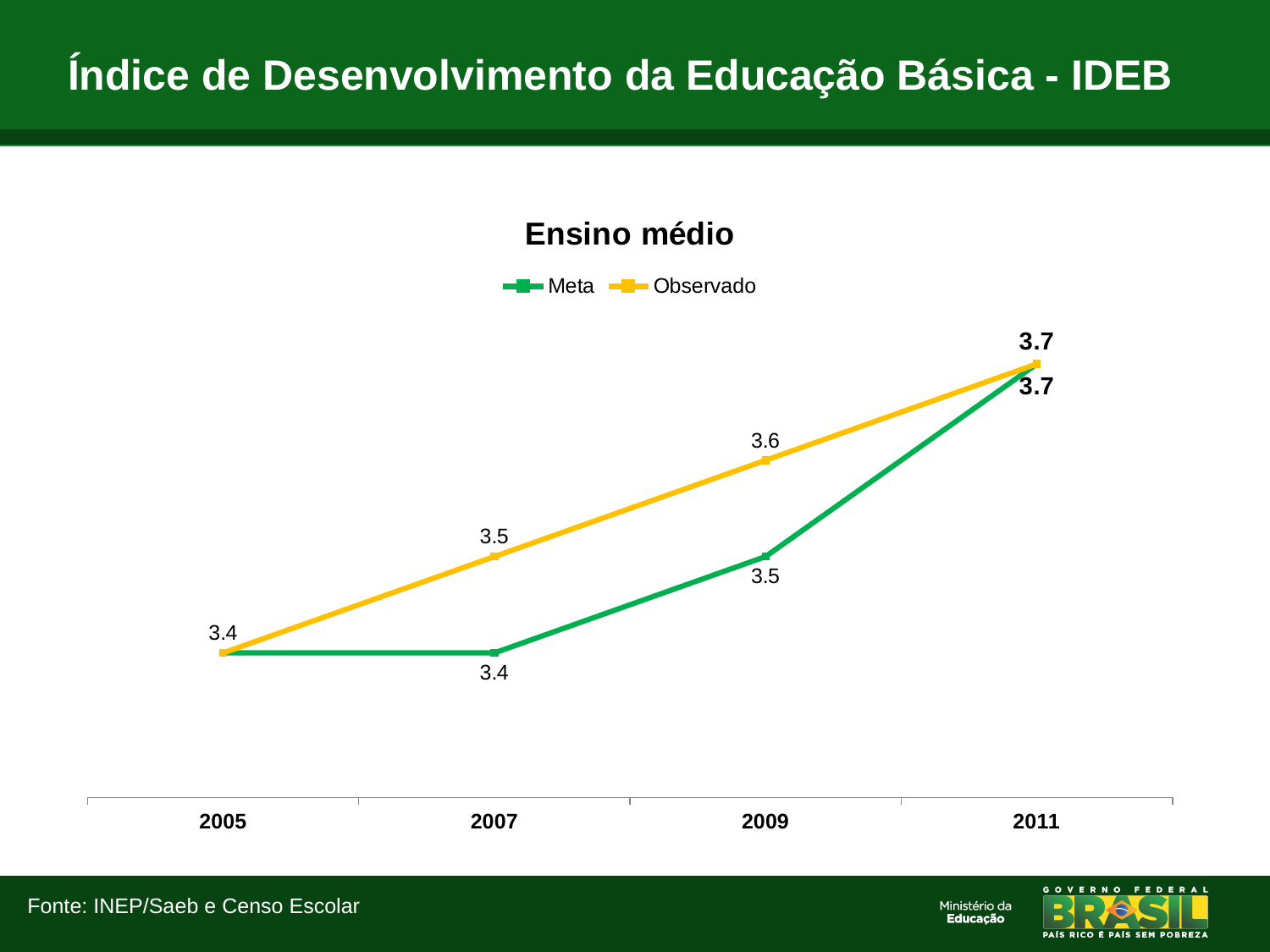
How many years are shown on the x axis? 4 What is the Observado value for 2007? 3.5 What is the Meta value for 2011? 3.7 How many series does the legend list? 2 What type of chart is shown on the slide? line chart In which year is the Observado series highest? 2011 What is the Observado value for 2009? 3.6 What is the difference between the Observado and Meta values in 2009? 0.1 Does the Observado series rise or fall from 2005 to 2011? rise What is the Meta value for 2007? 3.4 What is the title of the chart? Ensino médio In 2007, which series has the larger value, Meta or Observado? Observado